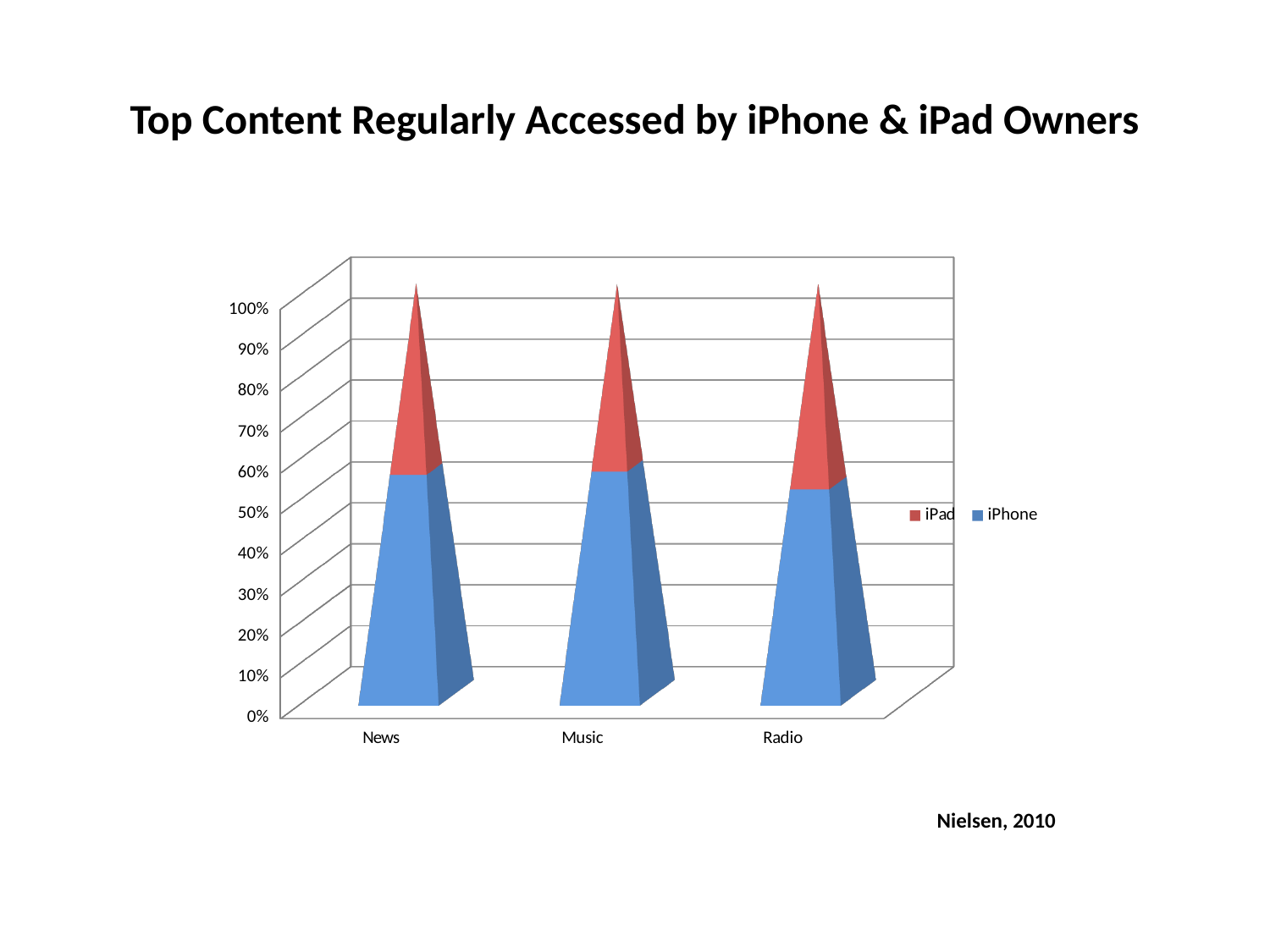
What kind of chart is shown on the slide? bar chart Which category has the largest iPad segment? Radio Which series is shown in red in the legend? iPad How many series does the legend list? 2 How many content categories are shown on the x axis? 3 Is the iPhone value for Music greater or less than 40%? greater Is the iPhone value for News greater or less than 70%? less What are the three categories listed on the x axis? News, Music, Radio What is the title of the chart? Top Content Regularly Accessed by iPhone & iPad Owners Which is larger, the iPhone segment for News or the iPhone segment for Radio? News Which category has the smallest iPhone segment? Radio